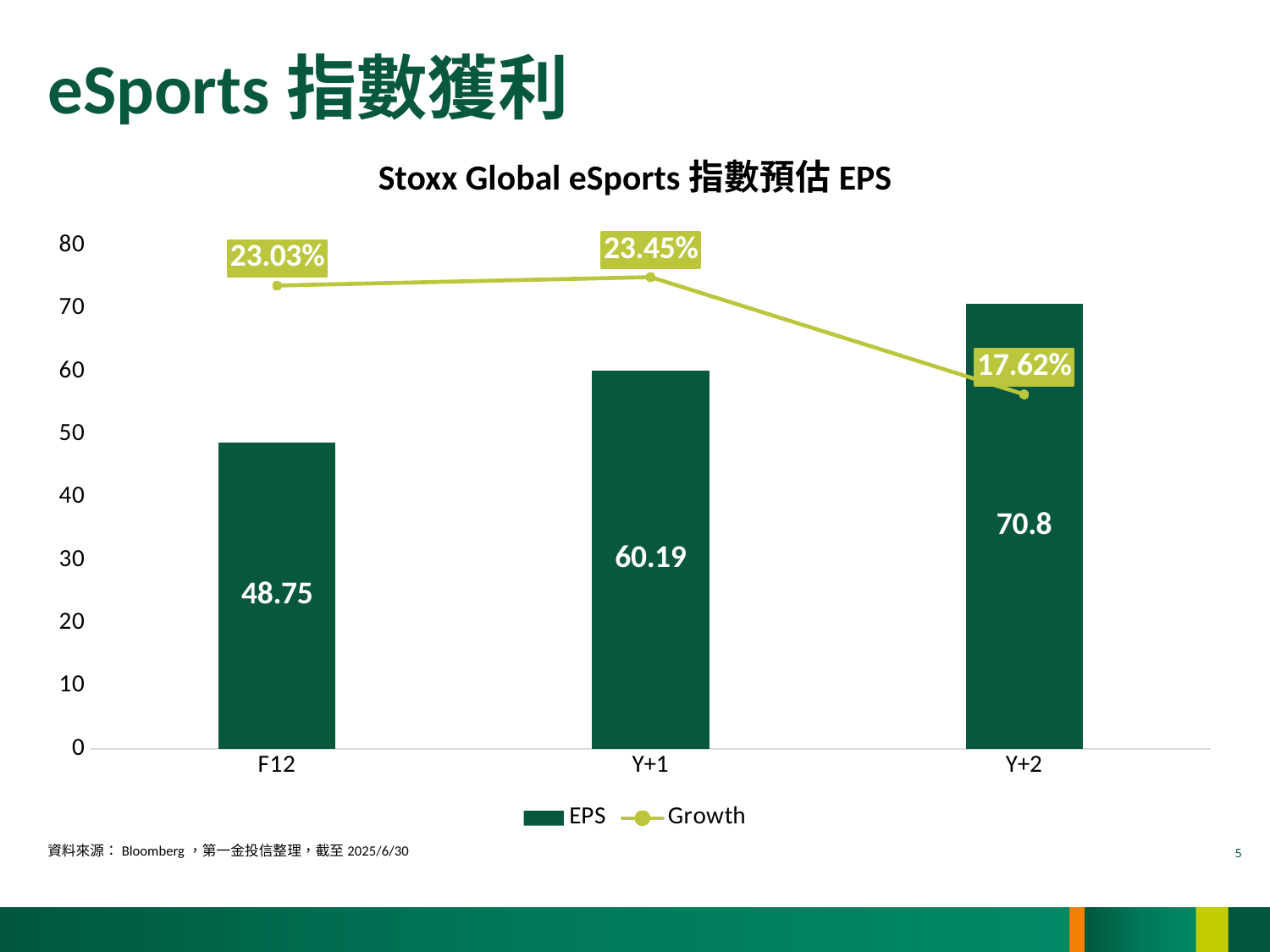
What is the difference in EPS between Y+2 and F12? 22.05 What is the Growth value for Y+2? 17.62% Which category has the highest EPS? Y+2 What is the title of the chart? Stoxx Global eSports 指數預估 EPS What is the EPS value for Y+1? 60.19 What is the EPS value for F12? 48.75 Do the EPS values rise or fall from F12 to Y+2? rise Which is larger, the Growth for F12 or the Growth for Y+1? Y+1 How many categories are shown on the x axis? 3 How many series does the legend list? 2 What is the Growth value for Y+1? 23.45% Which category has the lowest Growth? Y+2